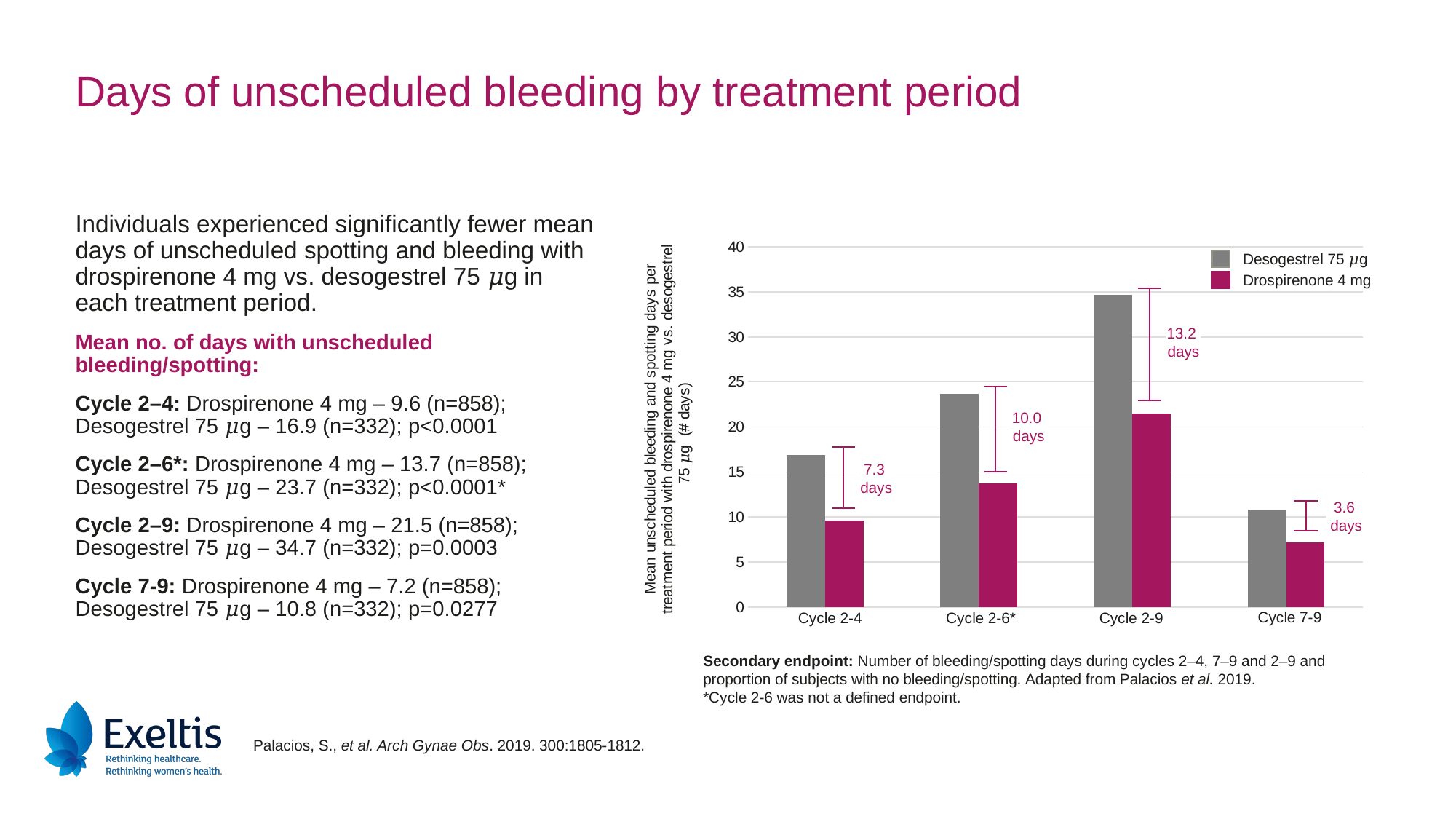
What is the difference in days between Desogestrel 75 µg and Drospirenone 4 mg shown for Cycle 2-4? 7.3 days Which treatment period has the lowest value for Drospirenone 4 mg? Cycle 7-9 Which colour represents Drospirenone 4 mg in the chart? magenta What kind of chart is shown on the slide? bar chart How many treatment period categories are shown on the x axis of the chart? 4 How many series does the chart legend list? 2 Which treatment period has the highest value for Desogestrel 75 µg? Cycle 2-9 What is the mean number of unscheduled bleeding/spotting days for Drospirenone 4 mg in Cycle 2-4, as stated on the slide? 9.6 What is the difference in days between Desogestrel 75 µg and Drospirenone 4 mg shown for Cycle 2-9? 13.2 days In Cycle 2-6*, which series has the larger value, Desogestrel 75 µg or Drospirenone 4 mg? Desogestrel 75 µg Is the value for Desogestrel 75 µg in Cycle 2-9 greater or less than 30? greater Is the value for Drospirenone 4 mg in Cycle 7-9 greater or less than 10? less